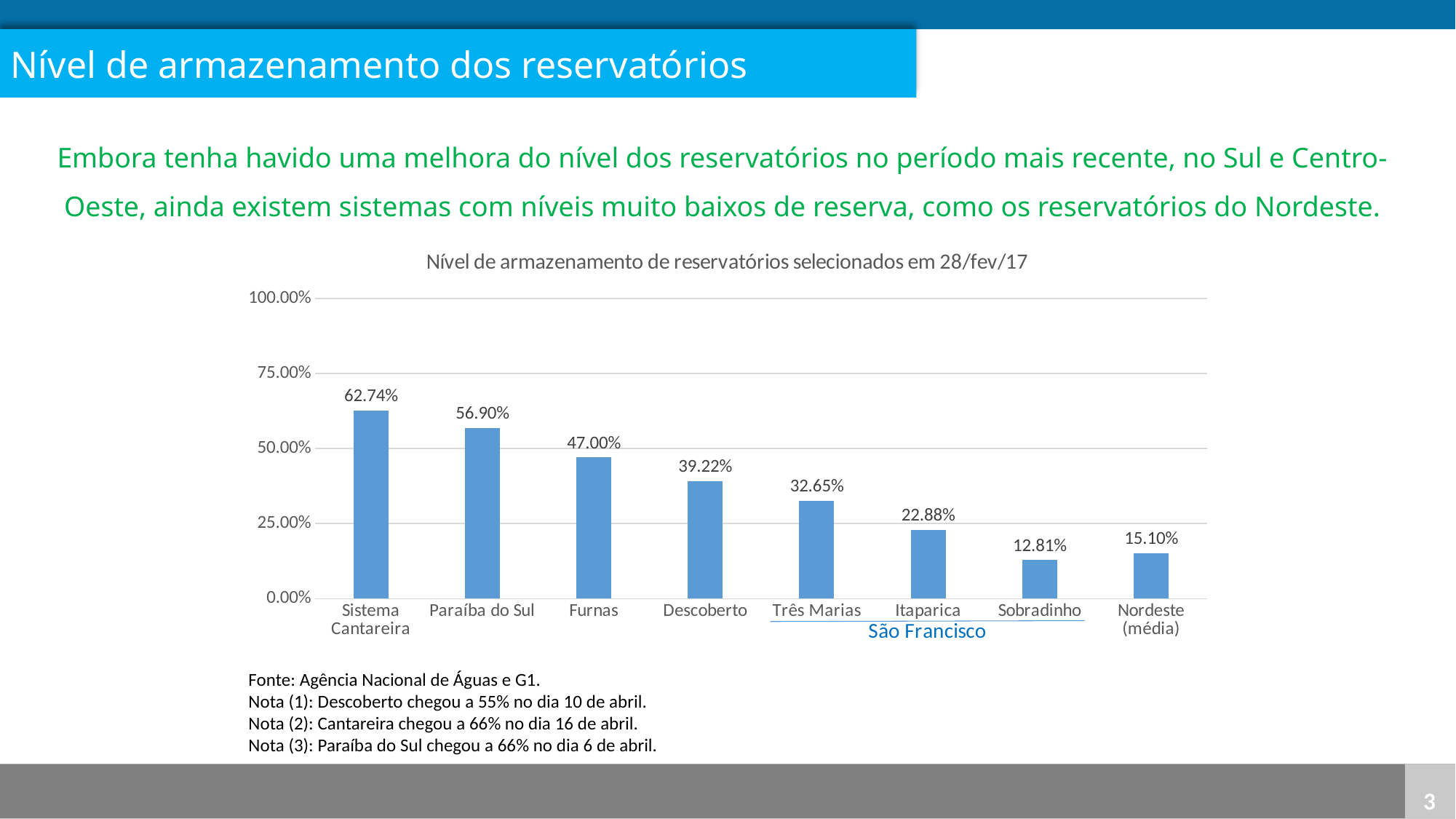
What type of chart is shown on the slide? Bar chart Is the value for Três Marias greater or less than 25.00%? greater Which reservoir has the lowest storage level? Sobradinho What is the value shown for Nordeste (média)? 15.10% What is the storage level for Sobradinho? 12.81% How many bars are shown in the chart? 8 What is the title of the chart? Nível de armazenamento de reservatórios selecionados em 28/fev/17 What is the storage level for Sistema Cantareira? 62.74% Which reservoir has the highest storage level? Sistema Cantareira What is the difference between the storage levels of Sistema Cantareira and Paraíba do Sul? 5.84% What is the difference between the values for Furnas and Descoberto? 7.78% Which has a higher storage level, Itaparica or Nordeste (média)? Itaparica